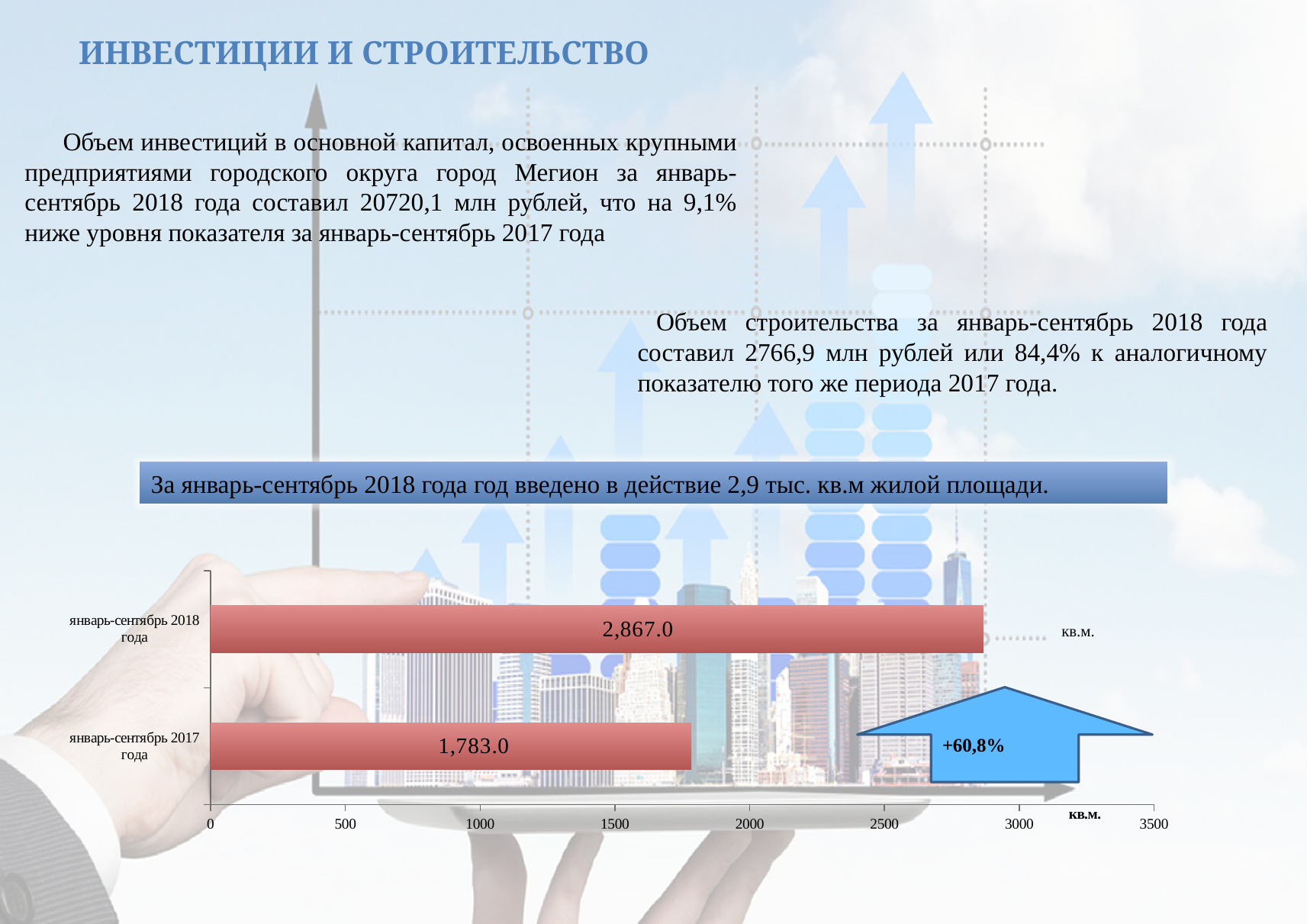
Which category has the highest value in the bar chart? январь-сентябрь 2018 года What is the value for январь-сентябрь 2018 года in the bar chart? 2,867.0 Is the value for январь-сентябрь 2018 года greater or less than 2500? greater What is the value for январь-сентябрь 2017 года in the bar chart? 1,783.0 Which category has the lowest value in the bar chart? январь-сентябрь 2017 года Which is larger: the value for январь-сентябрь 2018 года or for январь-сентябрь 2017 года? январь-сентябрь 2018 года What percentage change is shown in the arrow next to the bar chart? +60,8% How many categories are shown in the bar chart? 2 Is the value for январь-сентябрь 2017 года greater or less than 2000? less What type of chart is shown on the slide? bar chart What is the difference between the values for январь-сентябрь 2018 года and январь-сентябрь 2017 года? 1,084.0 What is the maximum value shown on the horizontal axis of the chart? 3500